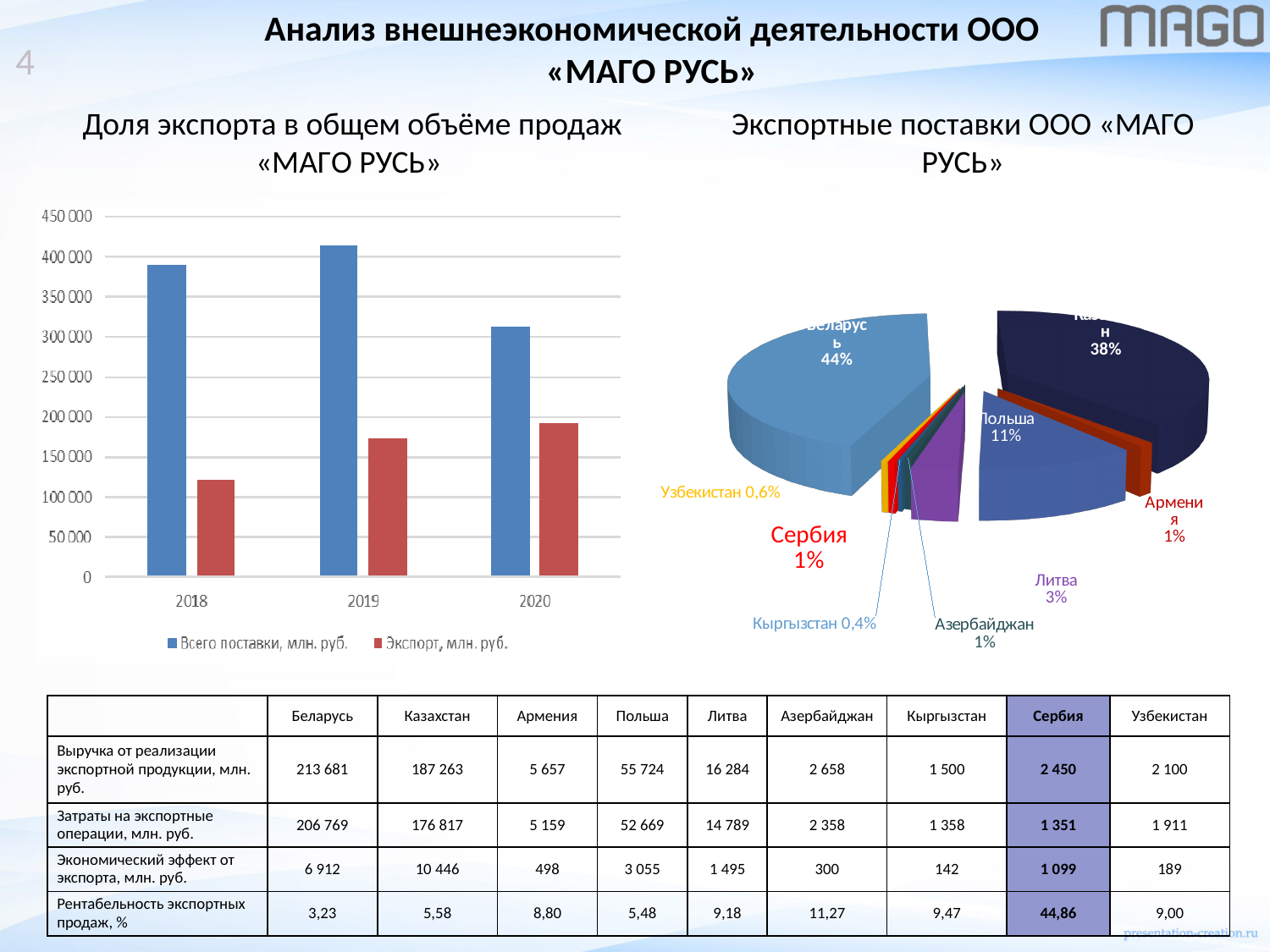
In the right pie chart, what share does Беларусь have? 44% In the right pie chart, which slice is the smallest? Кыргызстан In the left bar chart, how many series does the legend list? 2 In the left bar chart, how many years are shown on the x axis? 3 In the right pie chart, what is the difference between the shares of Беларусь and Польша? 33% What kind of chart is the right chart titled «Экспортные поставки ООО «МАГО РУСЬ»»? pie chart In the left bar chart, which year has the highest value for «Всего поставки, млн. руб.»? 2019 In the left bar chart, do the values for «Экспорт, млн. руб.» rise or fall from 2018 to 2020? rise In the left bar chart, is the value for «Экспорт, млн. руб.» in 2019 greater or less than 150 000? greater In the left bar chart, is the value for «Всего поставки, млн. руб.» in 2020 greater or less than 350 000? less In the left bar chart, which year has the lowest value for «Экспорт, млн. руб.»? 2018 What kind of chart is the left chart titled «Доля экспорта в общем объёме продаж «МАГО РУСЬ»»? bar chart